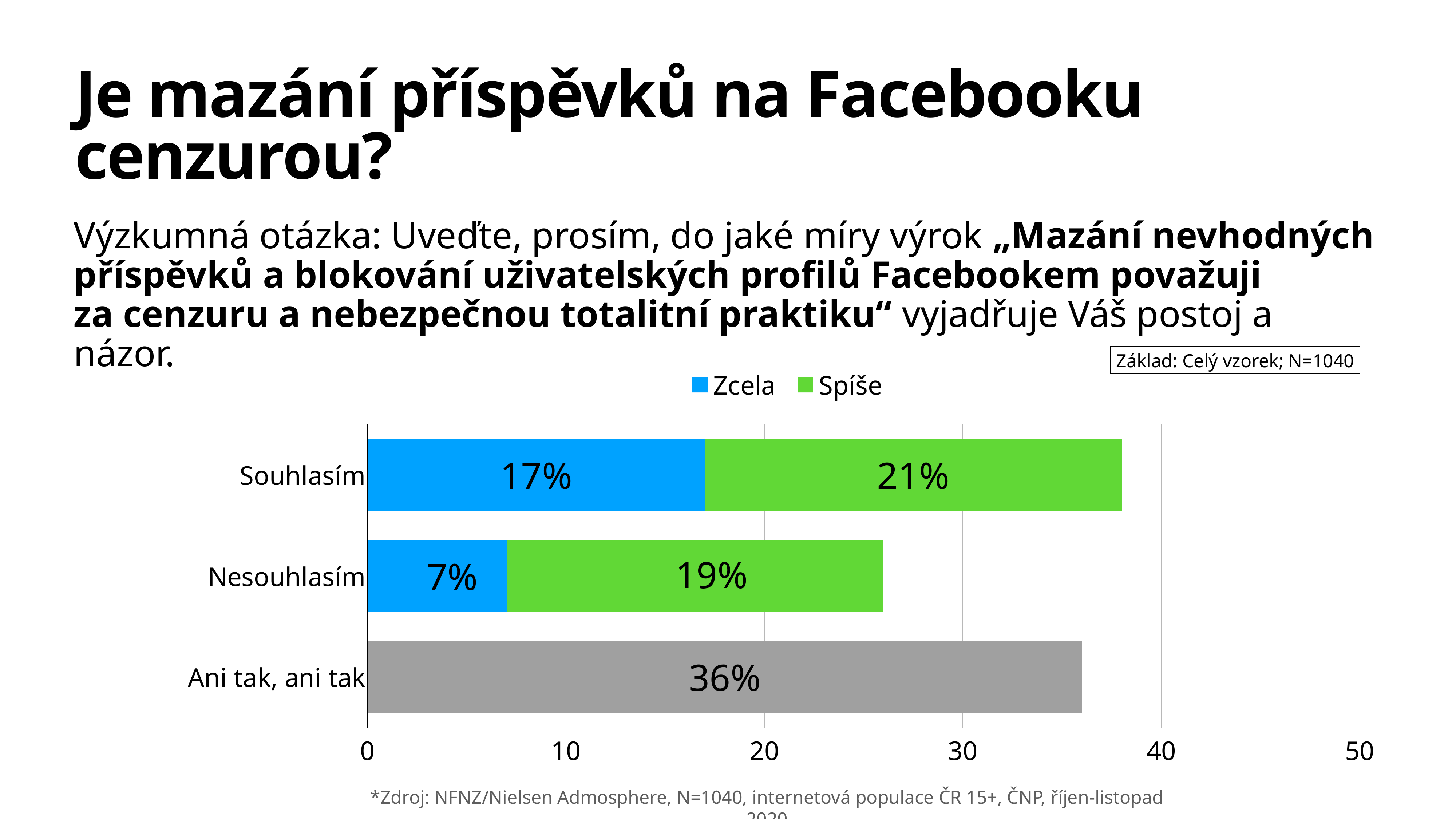
What is the Spíše value for Souhlasím? 21% What is the total of the stacked bar for Nesouhlasím? 26% How many series does the legend list? 2 What is the difference between the Zcela values for Souhlasím and Nesouhlasím? 10% What is the Spíše value for Nesouhlasím? 19% Which is larger: the Spíše value for Souhlasím or the Spíše value for Nesouhlasím? Souhlasím Which category has the lowest Zcela value? Nesouhlasím What kind of chart is shown on the slide? Stacked bar chart What is the total of the stacked bar for Souhlasím? 38% What is the Zcela value for Souhlasím? 17% What value is shown for Ani tak, ani tak? 36% How many categories are shown on the vertical axis? 3